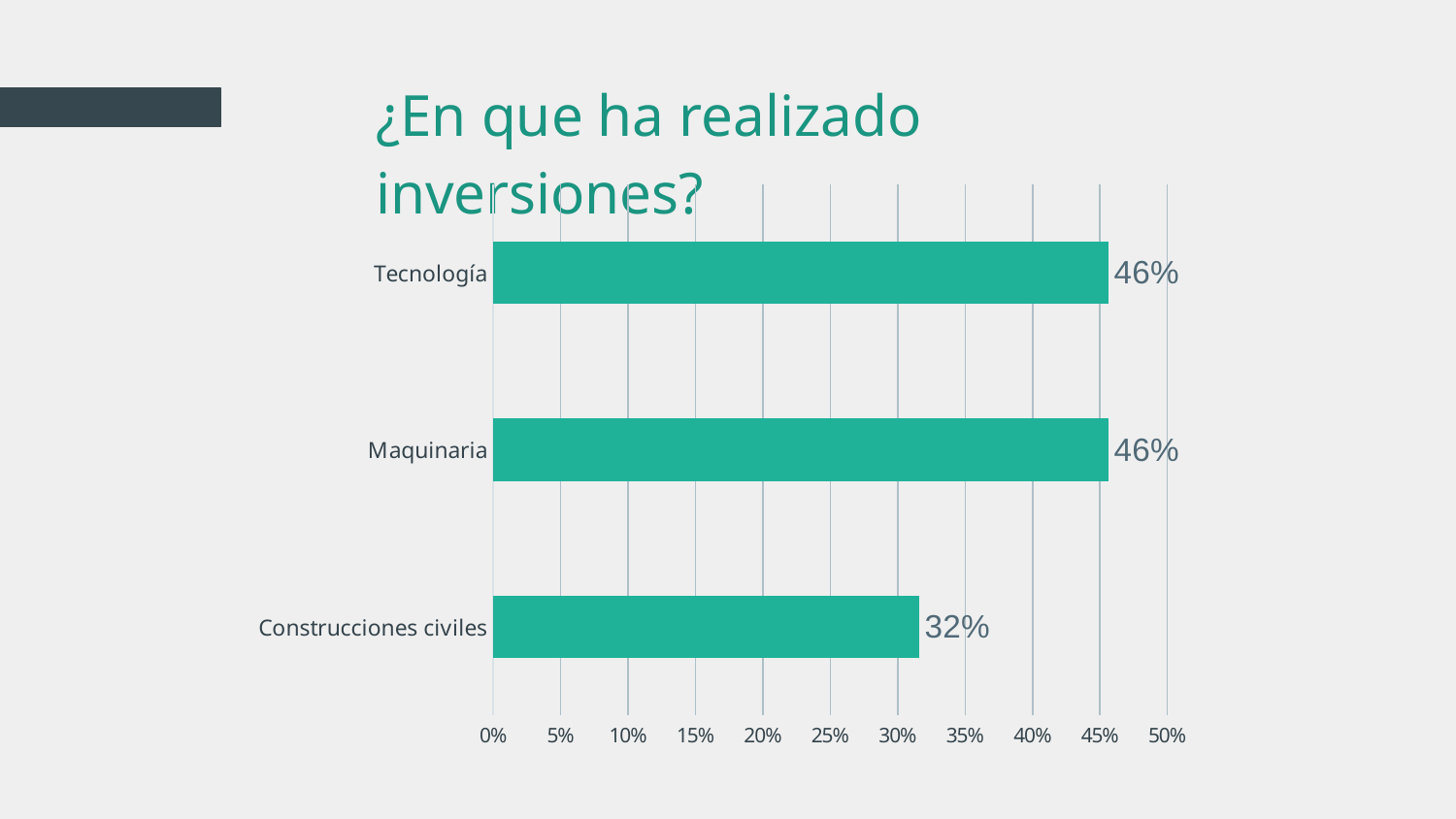
Which is larger, the value for Maquinaria or the value for Construcciones civiles? Maquinaria Is the value for Construcciones civiles greater or less than 35%? less What is the title of the chart? ¿En que ha realizado inversiones? What is the value for Tecnología? 46% What is the value for Maquinaria? 46% What kind of chart is shown on the slide? bar chart What is the value for Construcciones civiles? 32% How many categories are shown in the chart? 3 Is the value for Tecnología greater or less than 40%? greater Which category has the lowest value? Construcciones civiles What is the difference between the values for Maquinaria and Construcciones civiles? 14% What is the difference between the values for Tecnología and Construcciones civiles? 14%